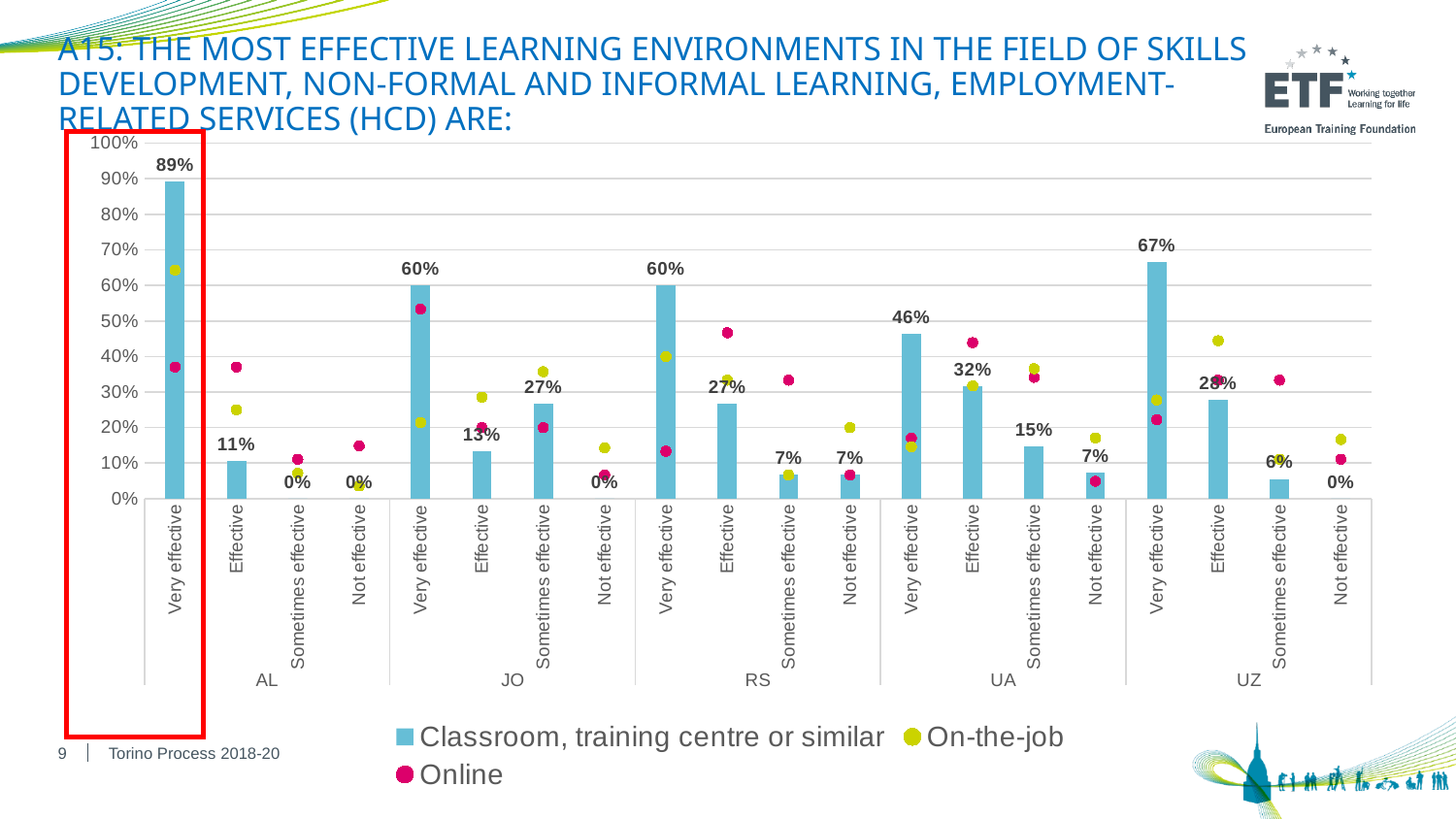
Which country has the highest Classroom, training centre or similar bar for Very effective? AL What is the value of the Classroom, training centre or similar bar for Very effective in AL? 89% How many countries are shown on the x axis? 5 What kind of chart is shown on the slide? Bar chart with markers What is the value of the Classroom, training centre or similar bar for Sometimes effective in JO? 27% Is the Online value for Effective in RS greater or less than 40%? greater Is the On-the-job value for Very effective in AL greater or less than 50%? greater What is the difference between the Classroom, training centre or similar bars for Very effective in UZ and UA? 21% What is the value of the Classroom, training centre or similar bar for Effective in UA? 32% Which is larger: the Classroom, training centre or similar bar for Effective in RS or for Effective in UZ? Effective in UZ Which series is shown as bars in the chart? Classroom, training centre or similar How many series does the legend list? 3